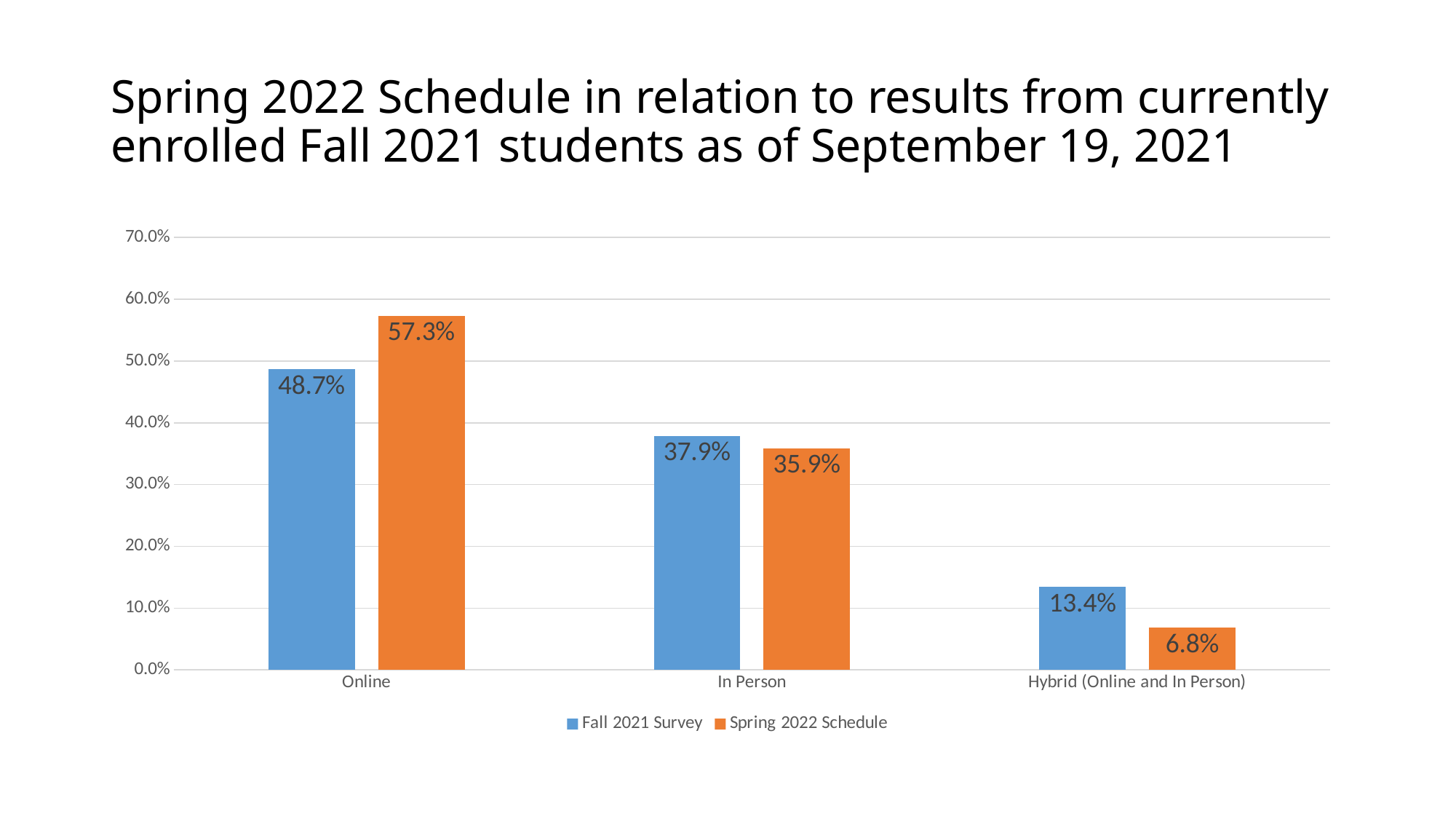
What is the Fall 2021 Survey value for Online? 48.7% What is the Fall 2021 Survey value for In Person? 37.9% Which category has the highest Spring 2022 Schedule value? Online What is the difference between the Spring 2022 Schedule and Fall 2021 Survey values for Online? 8.6% What is the Spring 2022 Schedule value for Online? 57.3% How many series does the legend list? 2 What is the Spring 2022 Schedule value for Hybrid (Online and In Person)? 6.8% What kind of chart is shown on the slide? Bar chart What is the difference between the Fall 2021 Survey and Spring 2022 Schedule values for Hybrid (Online and In Person)? 6.6% For In Person, which series has the larger value, Fall 2021 Survey or Spring 2022 Schedule? Fall 2021 Survey How many categories are shown on the x axis? 3 Which category has the lowest Fall 2021 Survey value? Hybrid (Online and In Person)